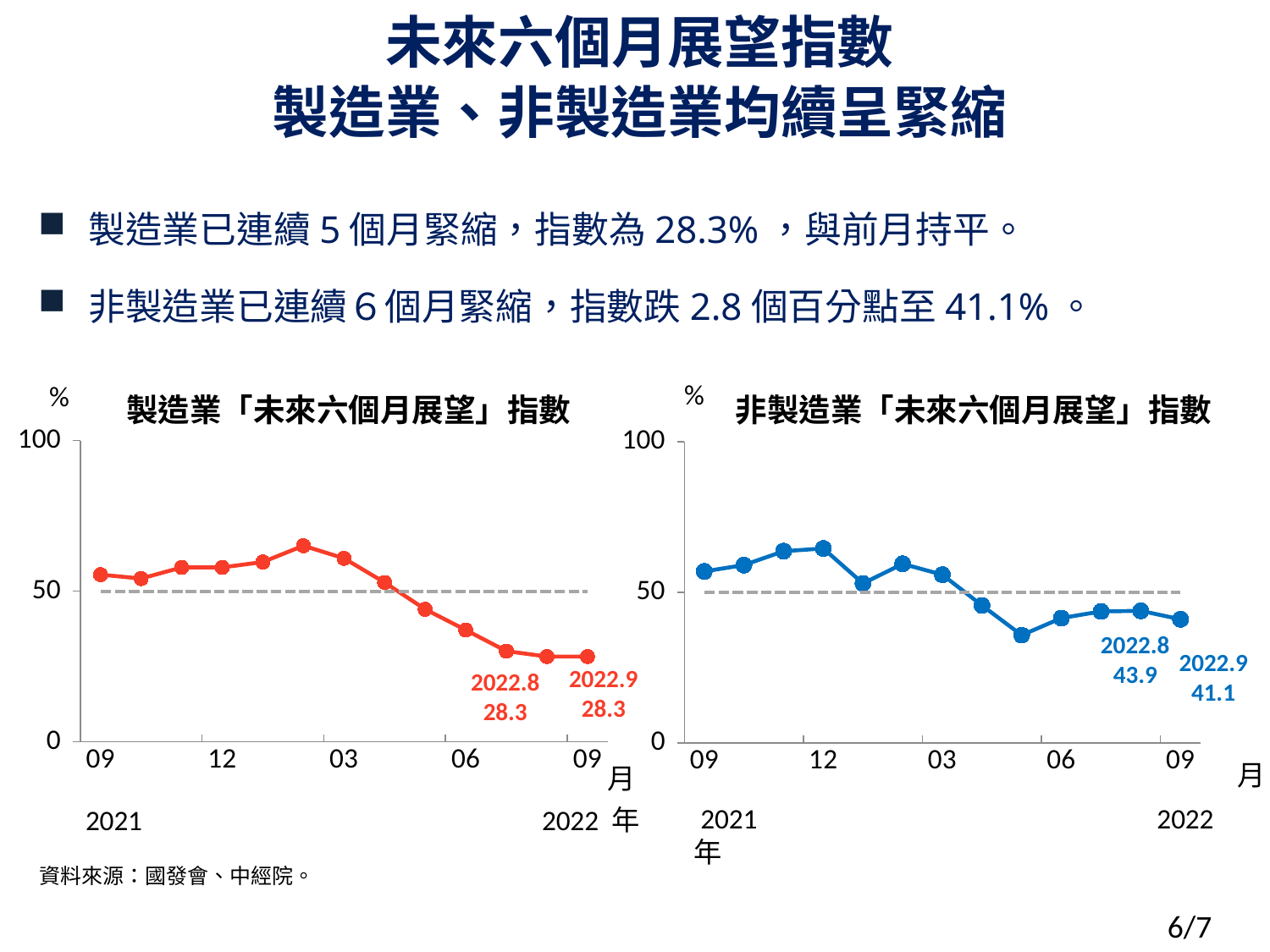
In the 非製造業「未來六個月展望」指數 chart, which month has the lowest value? 05 of 2022 In the 非製造業「未來六個月展望」指數 chart, what is the value for 2022.9? 41.1 In the 製造業「未來六個月展望」指數 chart, what is the value for 2022.8? 28.3 In the 製造業「未來六個月展望」指數 chart, is the value for 03 of 2022 greater or less than 50? greater In the 非製造業「未來六個月展望」指數 chart, what is the value for 2022.8? 43.9 In the 製造業「未來六個月展望」指數 chart, what is the value for 2022.9? 28.3 Which is larger for 2022.9: the 製造業 index or the 非製造業 index? 非製造業 What kind of chart is the 非製造業「未來六個月展望」指數 chart? line chart How many data points are plotted in the 製造業「未來六個月展望」指數 chart? 13 In the 製造業「未來六個月展望」指數 chart, which month has the highest value? 02 of 2022 In the 非製造業「未來六個月展望」指數 chart, is the value for 06 of 2022 greater or less than 50? less In the 非製造業「未來六個月展望」指數 chart, what is the difference between the 2022.8 and 2022.9 values? 2.8